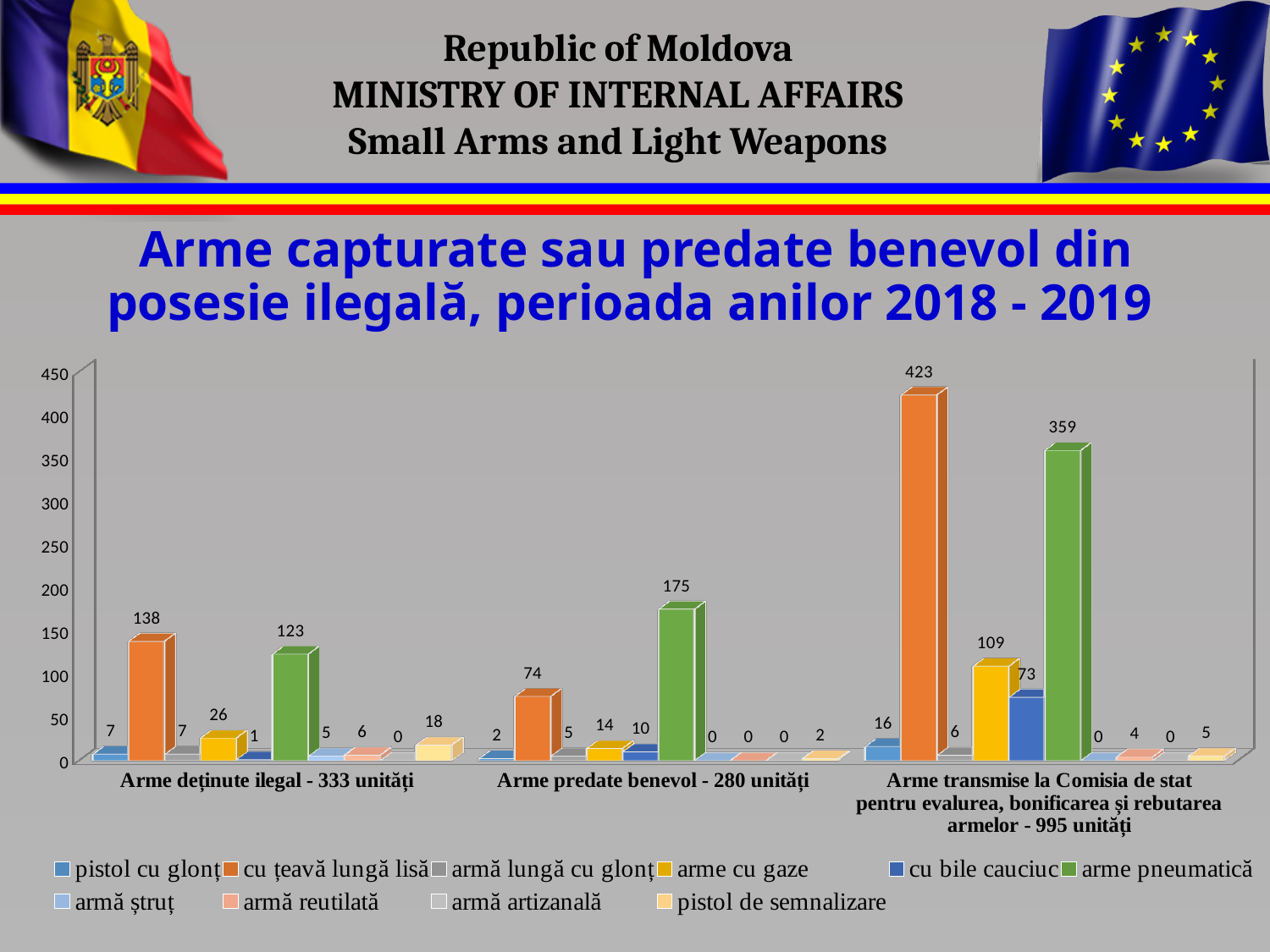
How many categories are shown on the x axis? 3 What is the value for 'arme pneumatică' in the 'Arme predate benevol - 280 unități' category? 175 What is the value for 'cu țeavă lungă lisă' in the 'Arme transmise la Comisia de stat pentru evalurea, bonificarea și rebutarea armelor - 995 unități' category? 423 How many series does the legend list? 10 What is the value for 'cu bile cauciuc' in the 'Arme transmise la Comisia de stat pentru evalurea, bonificarea și rebutarea armelor - 995 unități' category? 73 What is the difference between the 'arme pneumatică' value in 'Arme predate benevol' (175) and in 'Arme deținute ilegal' (123)? 52 In the 'Arme deținute ilegal - 333 unități' category, which is larger: 'cu țeavă lungă lisă' or 'arme pneumatică'? cu țeavă lungă lisă Which series has the highest value in the 'Arme transmise la Comisia de stat pentru evalurea, bonificarea și rebutarea armelor - 995 unități' category? cu țeavă lungă lisă What kind of chart is shown on the slide? bar chart What is the value for 'arme cu gaze' in the 'Arme deținute ilegal - 333 unități' category? 26 What is the difference between the 'cu țeavă lungă lisă' value (423) and the 'arme pneumatică' value (359) in the 'Arme transmise la Comisia de stat' category? 64 Is the value for 'arme pneumatică' in the 'Arme predate benevol - 280 unități' category greater or less than 150? greater